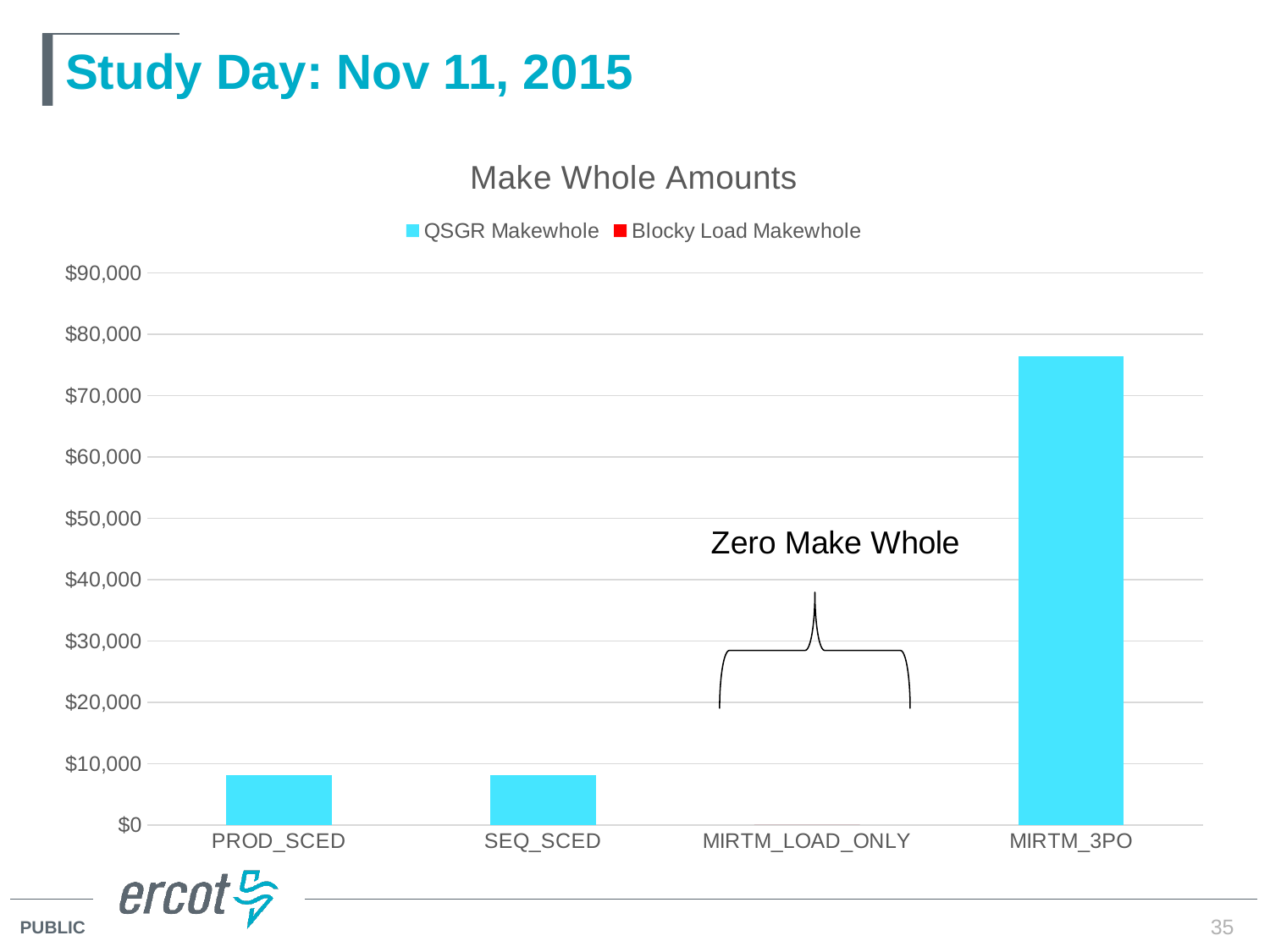
Which category has the highest make whole amount? MIRTM_3PO Is the value for PROD_SCED greater or less than $10,000? less Is the value for SEQ_SCED greater or less than $10,000? less What is the title of the chart? Make Whole Amounts Which category is annotated with the text 'Zero Make Whole'? MIRTM_LOAD_ONLY Is the value for MIRTM_3PO greater or less than $70,000? greater Which category has the lowest make whole amount? MIRTM_LOAD_ONLY What kind of chart is shown on the slide? Bar chart How many categories are shown on the x axis of the Make Whole Amounts chart? 4 Which is larger, the value for MIRTM_3PO or the value for PROD_SCED? MIRTM_3PO How many series does the legend of the Make Whole Amounts chart list? 2